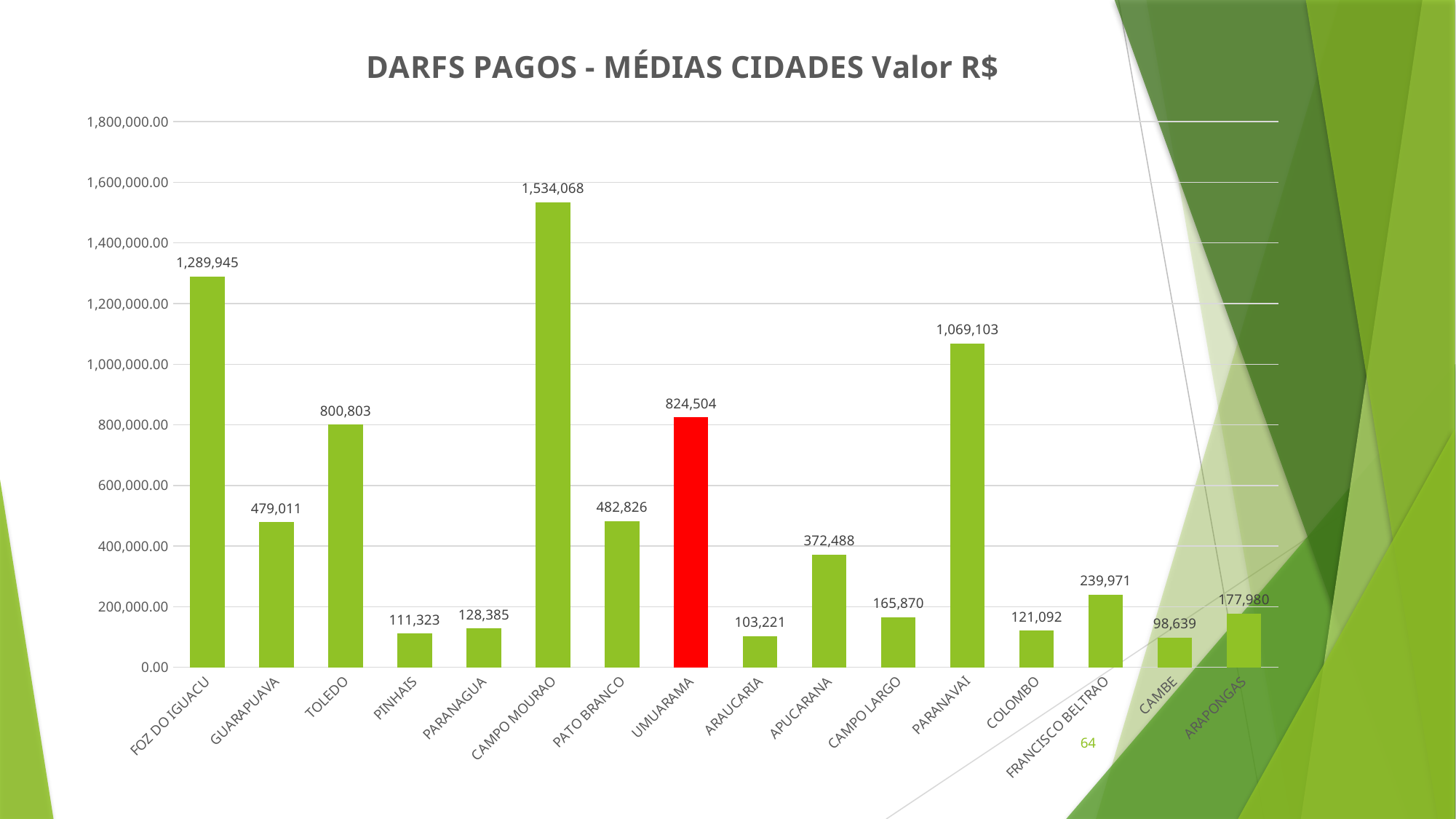
What is the value for CAMPO MOURAO? 1,534,068 Which city has the highest value? CAMPO MOURAO Which is larger, the value for APUCARANA or the value for FRANCISCO BELTRAO? APUCARANA What is the value for UMUARAMA? 824,504 How many cities are shown on the chart? 16 What kind of chart is shown on the slide? bar chart What is the value for FRANCISCO BELTRAO? 239,971 Which city has the lowest value? CAMBE What is the difference between the values for UMUARAMA and TOLEDO? 23,701 Which city's bar is coloured red? UMUARAMA Is the value for PARANAVAI greater or less than 1,000,000.00? greater What is the difference between the values for CAMPO MOURAO and FOZ DO IGUACU? 244,123